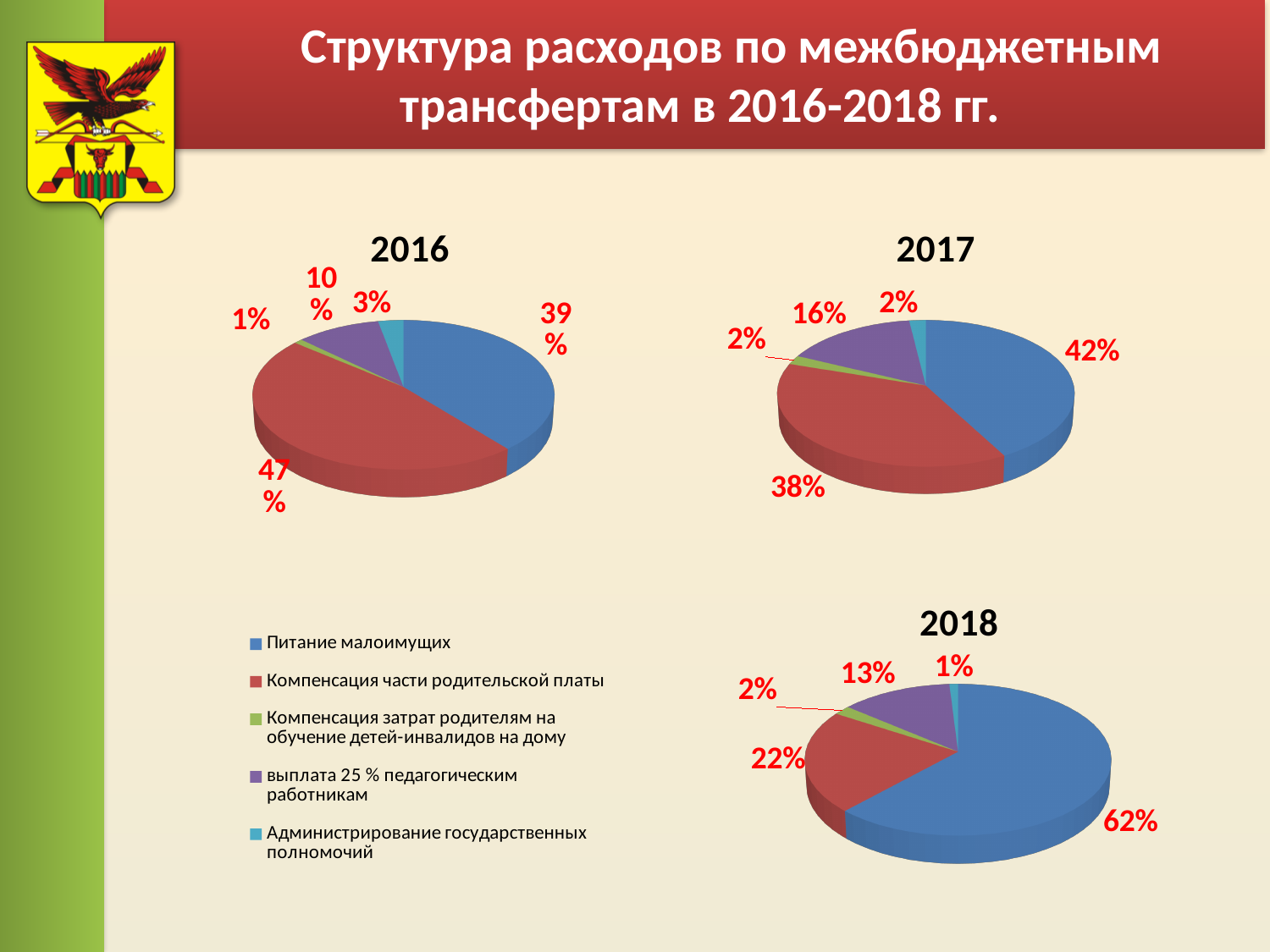
In the 2016 pie chart, which category has the smallest share? Компенсация затрат родителям на обучение детей-инвалидов на дому Which colour represents Администрирование государственных полномочий in the legend? Light blue In the 2016 pie chart, what share is shown for Компенсация части родительской платы? 47% In the 2018 pie chart, which category has the largest share? Питание малоимущих In the 2017 pie chart, what is the difference between the shares of Питание малоимущих and Компенсация части родительской платы? 4% In the 2016 pie chart, which is larger: the share of Питание малоимущих or the share of Компенсация части родительской платы? Компенсация части родительской платы What type of chart is used for 2017? Pie chart In the 2017 pie chart, what share is shown for Питание малоимущих? 42% How does the share of Питание малоимущих change from 2016 to 2018 across the three pie charts? It rises In the 2016 pie chart, what share is shown for выплата 25 % педагогическим работникам? 10% In the 2018 pie chart, what share is shown for Компенсация части родительской платы? 22% How many categories does the legend list? 5